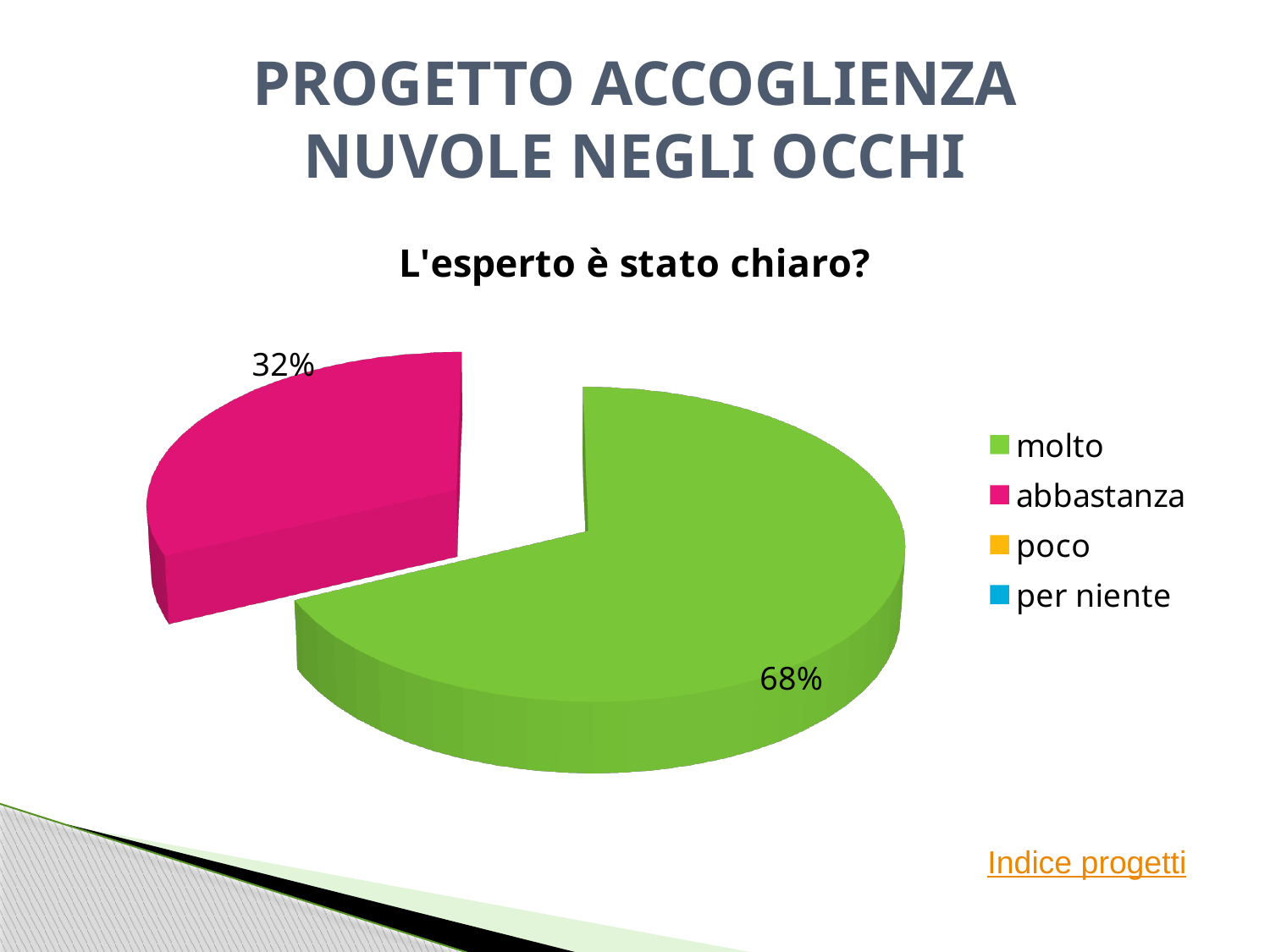
Is the share for 'molto' greater or less than 50%? greater What kind of chart is shown on the slide? pie chart How many slices are visible in the pie? 2 Which category has the largest share of the pie? molto What is the difference between the 'molto' share and the 'abbastanza' share? 36% Which is larger, the share for 'molto' or the share for 'abbastanza'? molto What colour is the 'abbastanza' slice? pink What percentage of the pie is 'molto'? 68% What percentage of the pie is 'abbastanza'? 32% What is the title of the chart? L'esperto è stato chiaro? How many entries does the legend list? 4